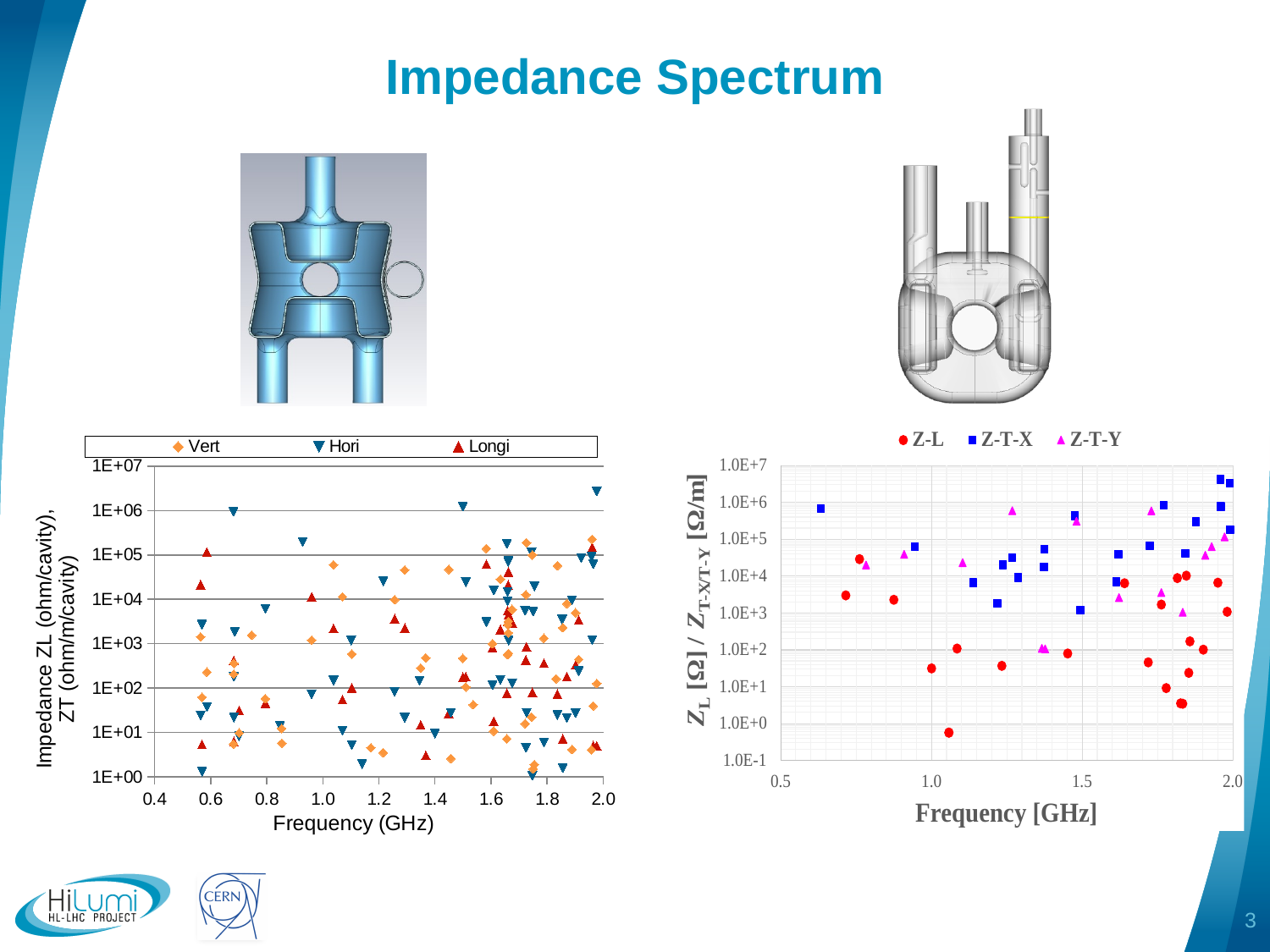
In the right chart, is the lowest Z-L value greater or less than 1.0E+0? less What kind of chart is the right chart with the Z-L, Z-T-X and Z-T-Y series? Scatter chart In the right chart, is the highest Z-T-X value greater or less than 1.0E+6? greater What kind of chart is the left chart with the Vert, Hori and Longi series? Scatter chart In the left chart, how many series does the legend list? 3 In the left chart, is the highest Hori value greater or less than 1E+06? greater In the right chart, what is the lowest value shown on the y axis? 1.0E-1 In the left chart, what is the highest value shown on the y axis? 1E+07 In the left chart, what is the range of the x axis in GHz? 0.4 to 2.0 In the right chart, how many series does the legend list? 3